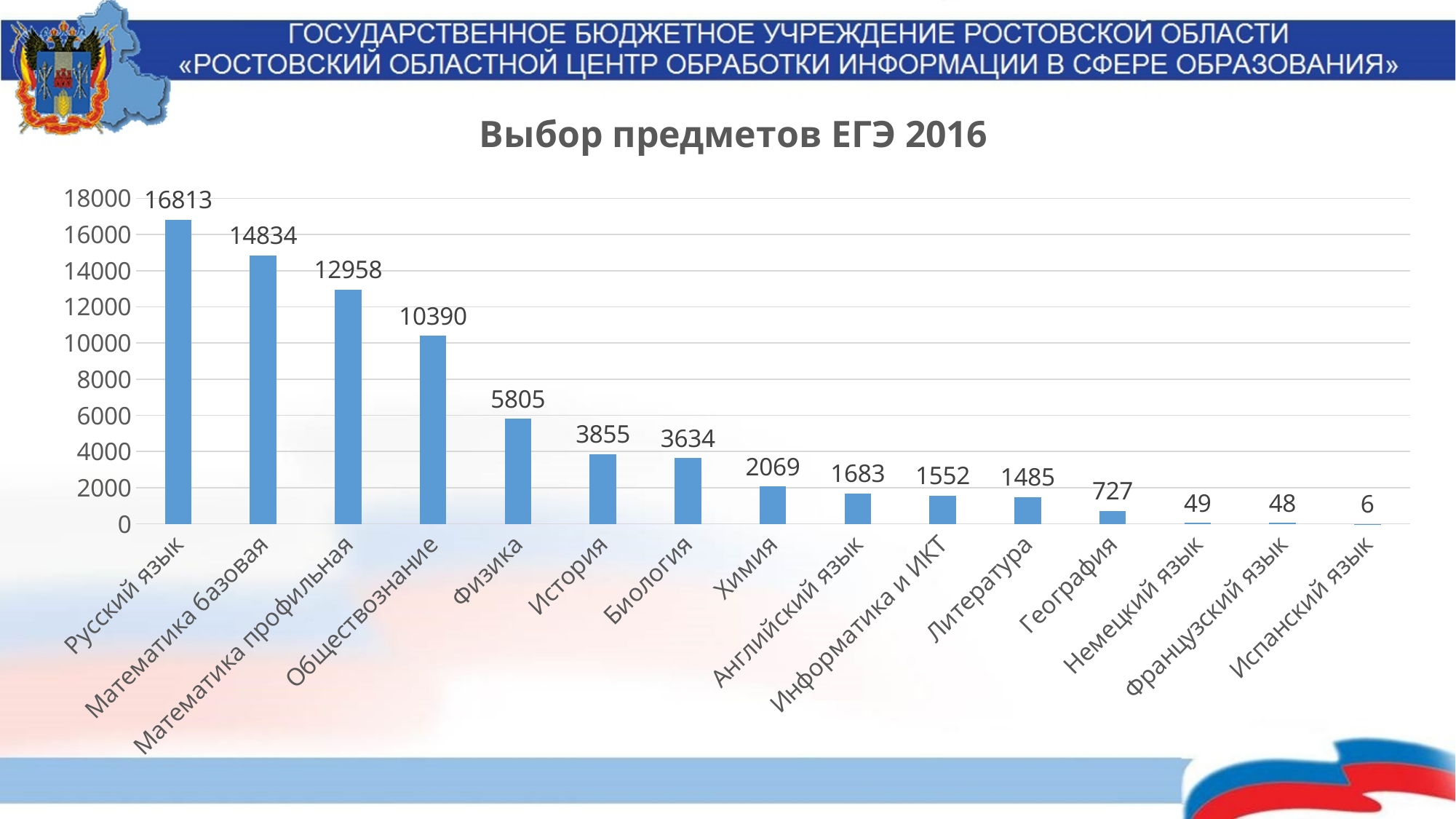
What is the title of the chart? Выбор предметов ЕГЭ 2016 Which is larger, the value for История or the value for Биология? История Is the value for Физика greater or less than 6000? less What is the difference between the values for Математика базовая and Математика профильная? 1876 What is the value for Информатика и ИКТ? 1552 What is the value for Обществознание? 10390 What is the value for Русский язык? 16813 What kind of chart is shown on the slide? bar chart Which subject has the highest value? Русский язык How many subjects are shown on the chart? 15 Do the values rise or fall from left to right along the x axis? fall Which subject has the lowest value? Испанский язык